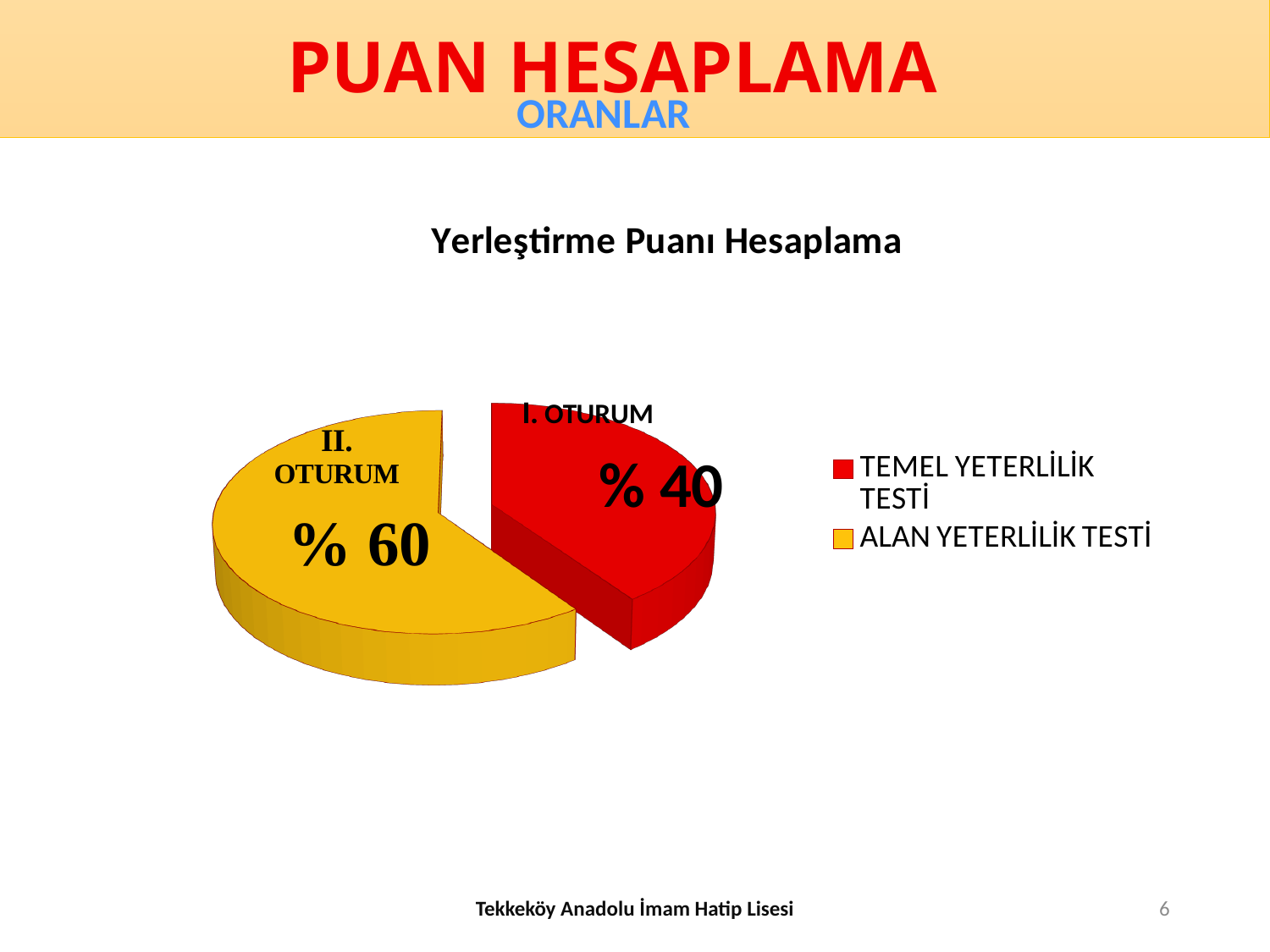
What is the chart's title? Yerleştirme Puanı Hesaplama What share of the pie does TEMEL YETERLİLİK TESTİ (I. OTURUM) take? % 40 How many slices does the pie chart have? 2 How many entries does the legend list? 2 What is the difference in percentage points between the II. OTURUM slice and the I. OTURUM slice? 20 What colour is the ALAN YETERLİLİK TESTİ slice? yellow Which is larger, the I. OTURUM slice or the II. OTURUM slice? II. OTURUM Which slice is the largest? ALAN YETERLİLİK TESTİ What share of the pie does ALAN YETERLİLİK TESTİ (II. OTURUM) take? % 60 Which slice is the smallest? TEMEL YETERLİLİK TESTİ What kind of chart is shown on the slide? pie chart